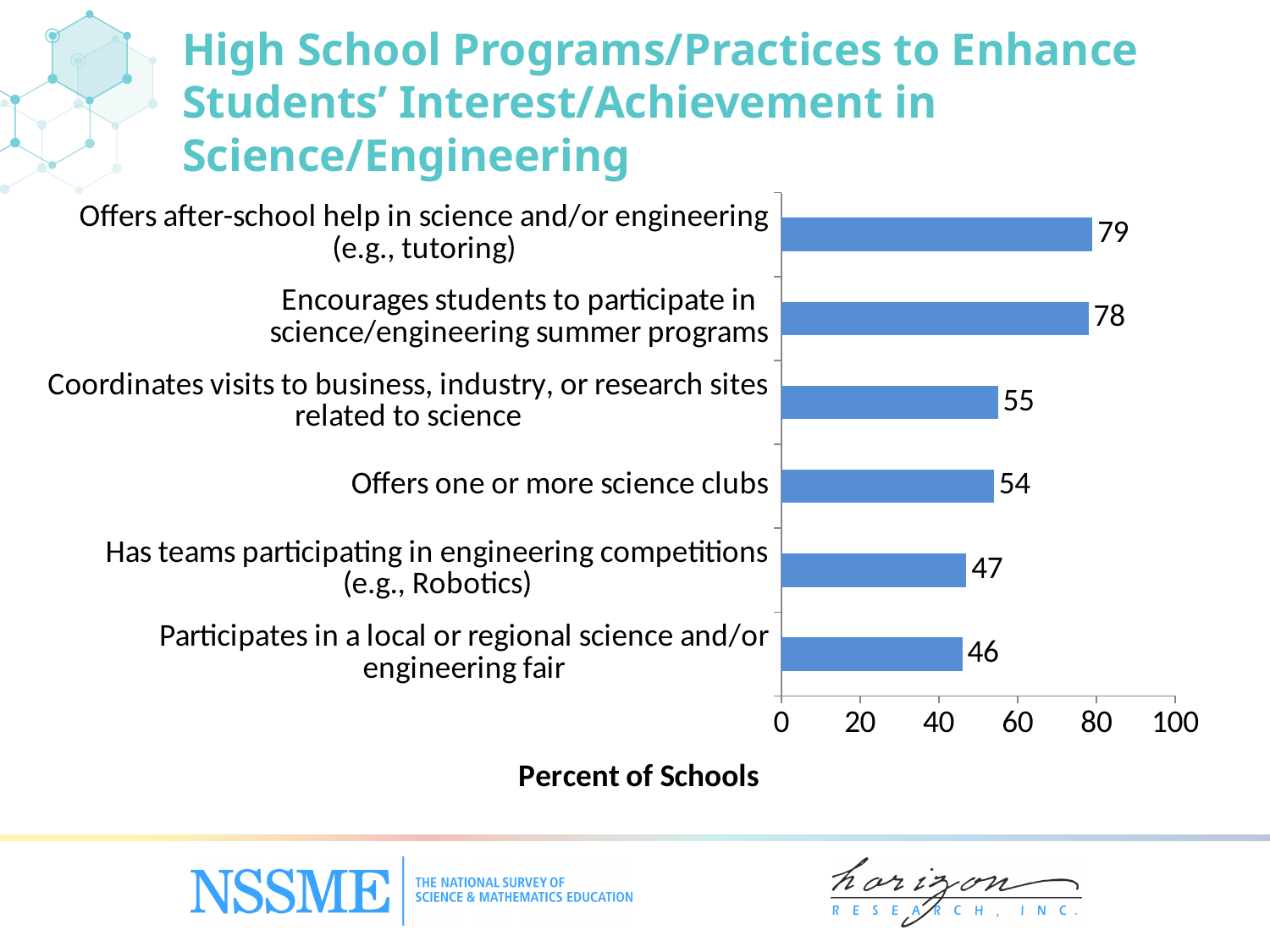
Which has a larger percent of schools: 'Offers one or more science clubs' or 'Has teams participating in engineering competitions (e.g., Robotics)'? Offers one or more science clubs What is the value for 'Coordinates visits to business, industry, or research sites related to science'? 55 What percent of schools offer after-school help in science and/or engineering (e.g., tutoring)? 79 Which program/practice has the lowest percent of schools? Participates in a local or regional science and/or engineering fair What percent of schools have teams participating in engineering competitions (e.g., Robotics)? 47 Which program/practice has the highest percent of schools? Offers after-school help in science and/or engineering (e.g., tutoring) What is the label of the horizontal axis? Percent of Schools What is the difference between the values for 'Offers one or more science clubs' and 'Has teams participating in engineering competitions'? 7 What kind of chart is shown on the slide? Bar chart How many programs/practices are shown in the chart? 6 What percent of schools encourage students to participate in science/engineering summer programs? 78 What is the difference in percent of schools between 'Offers after-school help in science and/or engineering' and 'Participates in a local or regional science and/or engineering fair'? 33